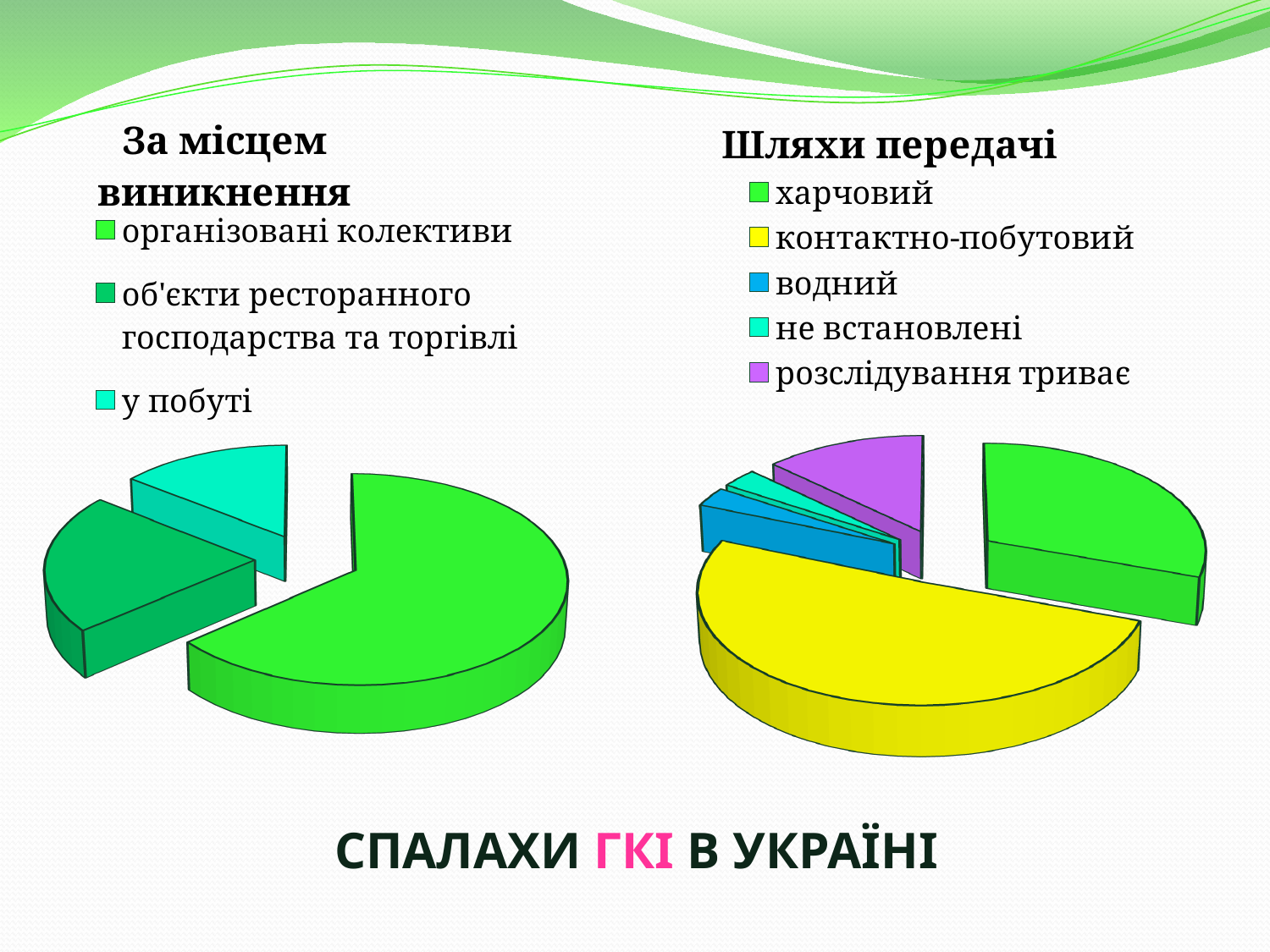
In the chart titled "Шляхи передачі", how many categories are shown? 5 In the chart titled "Шляхи передачі", which slice is larger: харчовий or не встановлені? харчовий In the chart titled "Шляхи передачі", what colour is the slice for контактно-побутовий? yellow In the chart titled "Шляхи передачі", which category has the largest slice? контактно-побутовий In the chart titled "Шляхи передачі", which slice is larger: контактно-побутовий or водний? контактно-побутовий What kind of chart is the chart titled "Шляхи передачі"? pie chart In the chart titled "За місцем виникнення", how many categories are shown? 3 In the chart titled "Шляхи передачі", which category is shown in purple? розслідування триває In the chart titled "Шляхи передачі", which slice is larger: харчовий or розслідування триває? харчовий In the chart titled "За місцем виникнення", which category has the largest slice? організовані колективи What kind of chart is the chart titled "За місцем виникнення"? pie chart